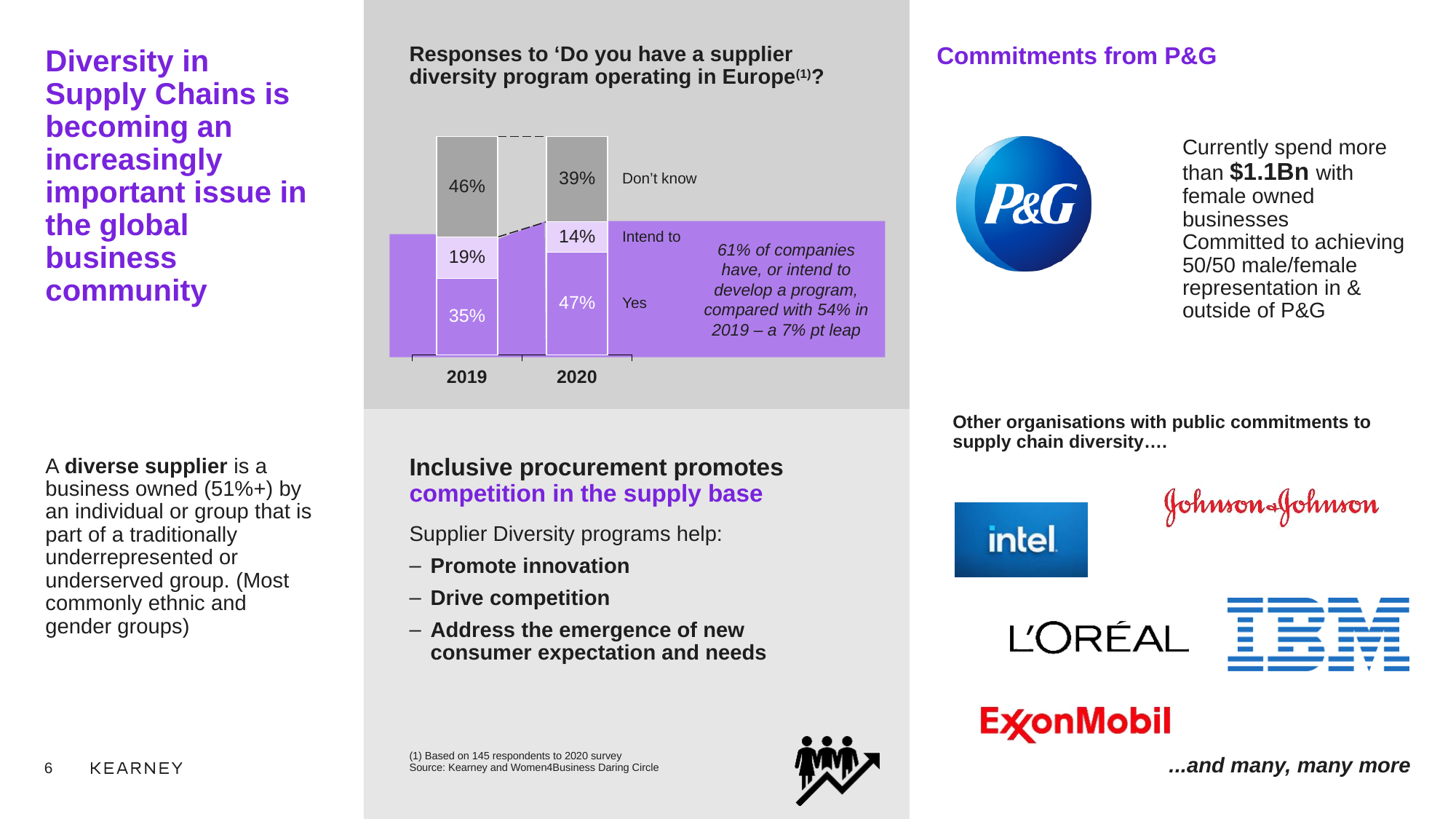
Which response category had the smallest share in 2020? Intend to By how many percentage points did the 'Yes' share increase from 2019 to 2020? 12 Did the 'Intend to' share rise or fall from 2019 to 2020? Fall What percentage of respondents answered 'Yes' in 2020? 47% How many years are shown on the x axis of the chart? 2 What type of chart is used to show the survey responses? Stacked bar chart What percentage of respondents answered 'Intend to' in 2020? 14% What percentage of respondents answered 'Intend to' in 2019? 19% How many response categories are stacked in each bar? 3 Which year had a higher 'Don't know' share, 2019 or 2020? 2019 What percentage of respondents answered 'Don't know' in 2019? 46% Which response category had the largest share in 2019? Don't know